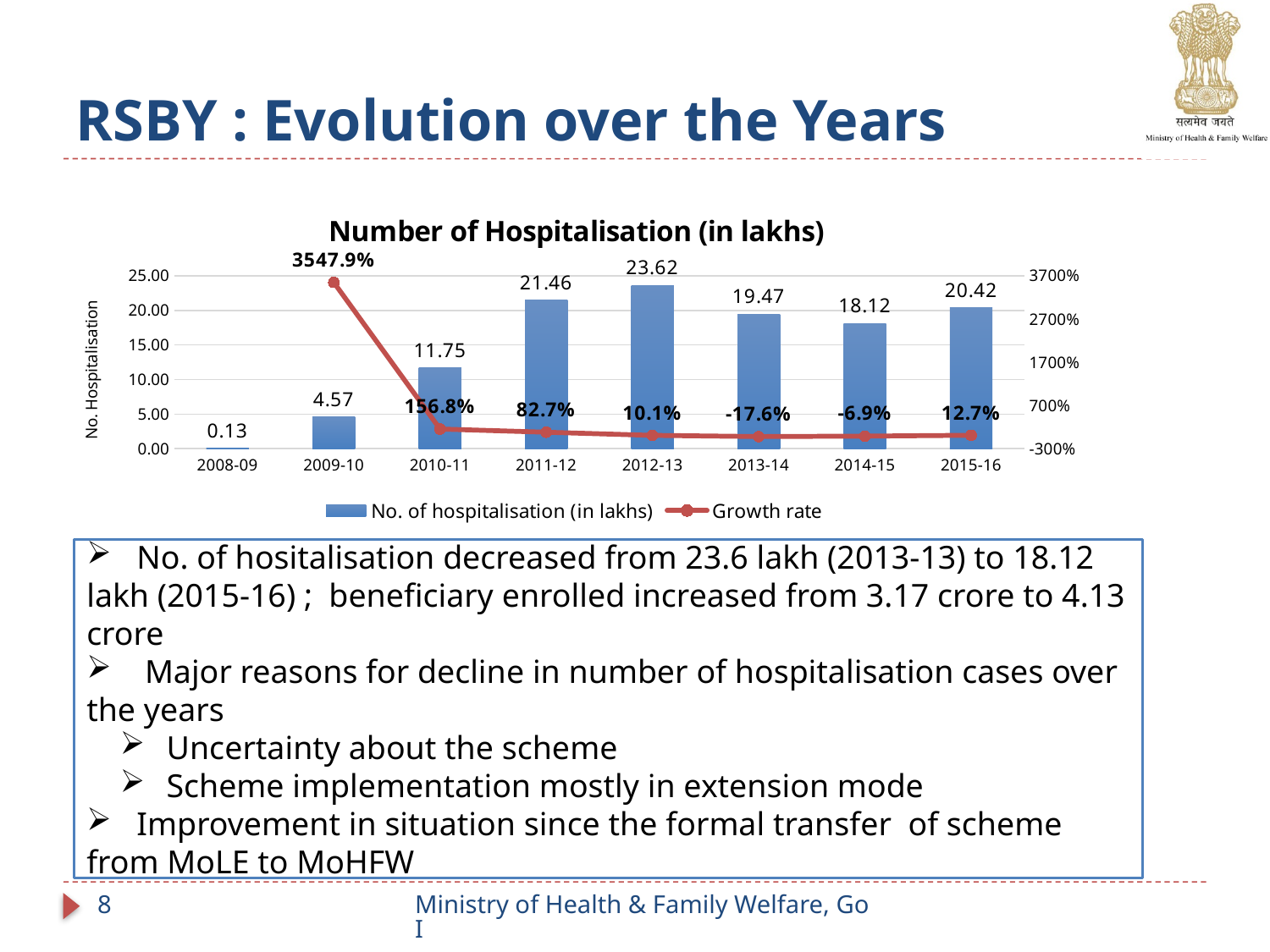
Which year has the highest number of hospitalisation (in lakhs)? 2012-13 What is the title of the chart? Number of Hospitalisation (in lakhs) Which year has a larger number of hospitalisation (in lakhs), 2011-12 or 2014-15? 2011-12 What is the number of hospitalisation (in lakhs) for 2012-13? 23.62 What is the growth rate shown for 2009-10? 3547.9% Which year has the lowest number of hospitalisation (in lakhs)? 2008-09 How many series does the chart legend list? 2 Does the number of hospitalisation (in lakhs) rise or fall from 2012-13 to 2014-15? fall What is the number of hospitalisation (in lakhs) for 2015-16? 20.42 What is the difference in number of hospitalisation (in lakhs) between 2012-13 and 2013-14? 4.15 What is the growth rate shown for 2013-14? -17.6% How many years are shown on the x axis of the chart? 8